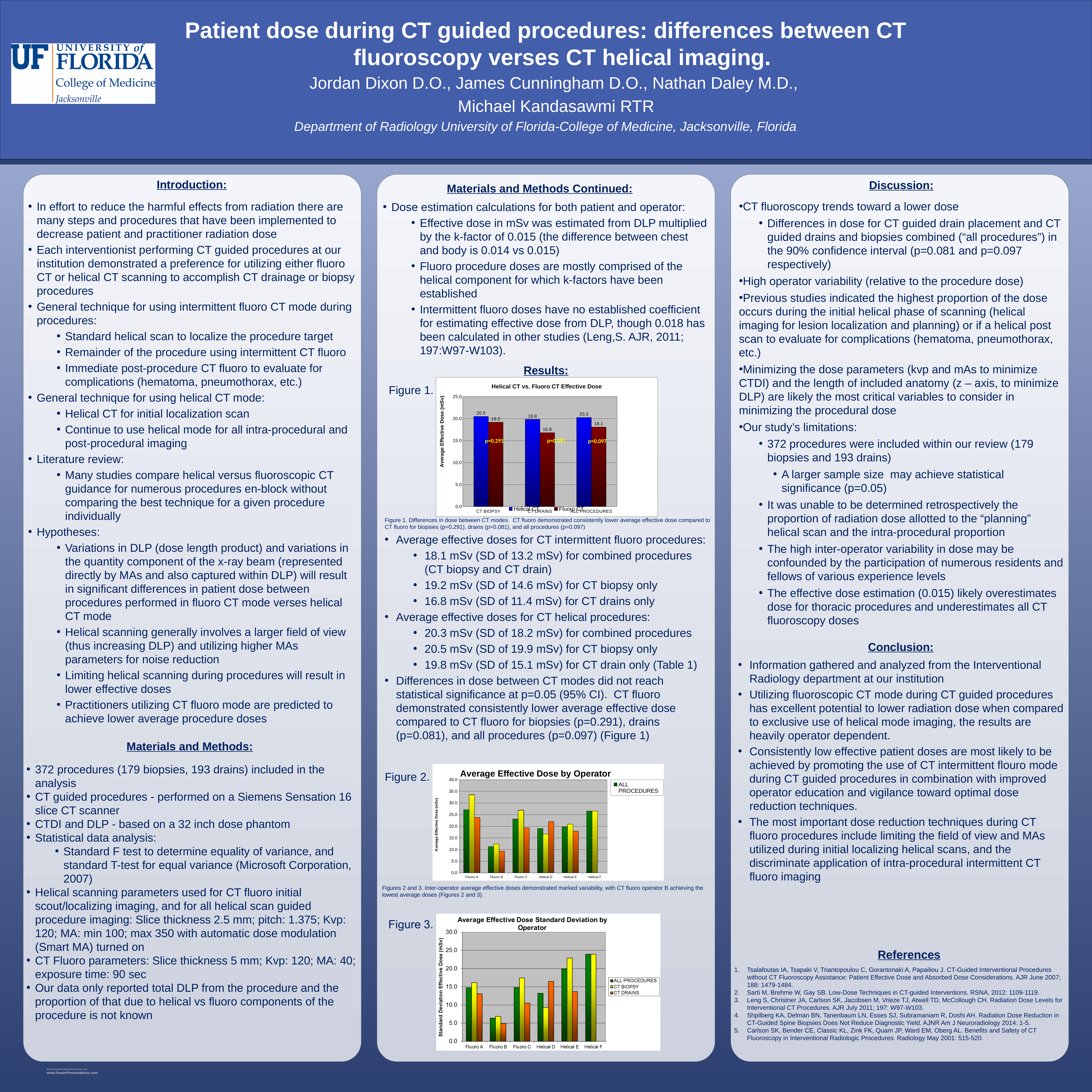
In Figure 2 (Average Effective Dose by Operator), is the ALL PROCEDURES value for Fluoro B greater or less than 15.0? less In Figure 1 (Helical CT vs. Fluoro CT Effective Dose), which is larger for ALL PROCEDURES, Helical CT or Fluoro CT? Helical CT How many series does the legend of Figure 1 (Helical CT vs. Fluoro CT Effective Dose) list? 2 How many series does the legend of Figure 3 (Average Effective Dose Standard Deviation by Operator) list? 3 How many operator categories are shown on the x axis of Figure 2 (Average Effective Dose by Operator)? 6 In Figure 3 (Average Effective Dose Standard Deviation by Operator), is the ALL PROCEDURES value for Helical F greater or less than 20.0? greater What kind of chart is Figure 1 (Helical CT vs. Fluoro CT Effective Dose)? bar chart In Figure 1 (Helical CT vs. Fluoro CT Effective Dose), what is the Helical CT value for CT BIOPSY? 20.5 In Figure 1 (Helical CT vs. Fluoro CT Effective Dose), which category has the lowest Fluoro CT value? CT DRAINS In Figure 1 (Helical CT vs. Fluoro CT Effective Dose), what is the Fluoro CT value for CT DRAINS? 16.8 In Figure 1 (Helical CT vs. Fluoro CT Effective Dose), what is the difference between the Helical CT and Fluoro CT values for CT DRAINS? 3.0 How many categories are shown on the x axis of Figure 1 (Helical CT vs. Fluoro CT Effective Dose)? 3